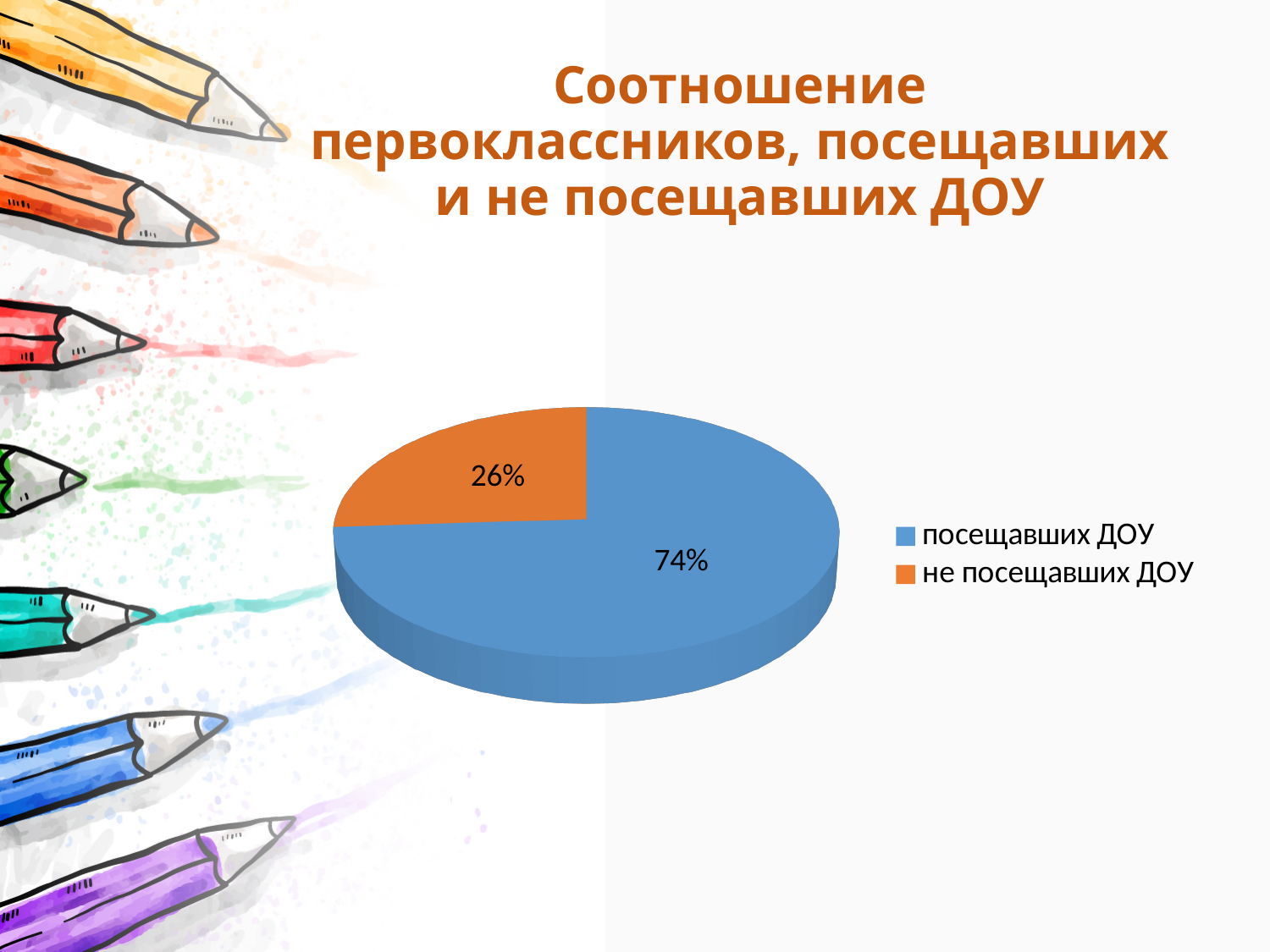
What share of the pie does "посещавших ДОУ" take? 74% What is the difference in percentage points between "посещавших ДОУ" and "не посещавших ДОУ"? 48 How many slices does the pie chart have? 2 Which category has the smallest slice of the pie? не посещавших ДОУ Which category has the largest slice of the pie? посещавших ДОУ What share of the pie does "не посещавших ДОУ" take? 26% What colour is the slice for "не посещавших ДОУ"? orange What kind of chart is shown on the slide? pie chart Which is larger: the slice for "посещавших ДОУ" or the slice for "не посещавших ДОУ"? посещавших ДОУ What is the title of the slide containing the chart? Соотношение первоклассников, посещавших и не посещавших ДОУ How many entries does the legend list? 2